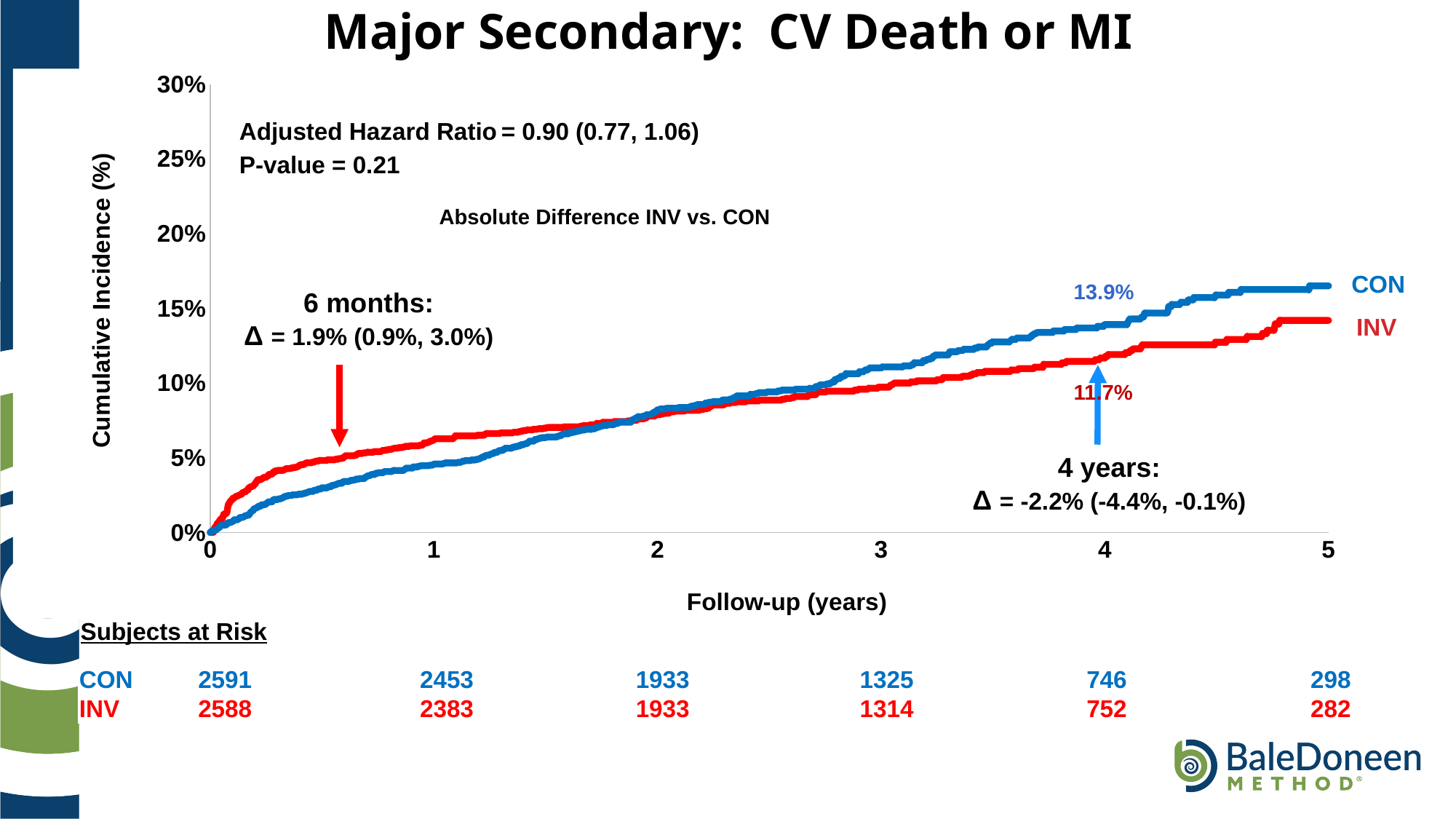
At 6 months, which group has the higher cumulative incidence, CON or INV? INV What kind of chart is shown on the slide? line chart How many INV subjects are at risk at year 5? 282 Do the cumulative incidence curves rise or fall as follow-up time increases? rise What is the cumulative incidence for INV at 4 years? 11.7% How many CON subjects are at risk at year 0? 2591 What adjusted hazard ratio is reported on the chart? 0.90 (0.77, 1.06) By how many percentage points does the CON cumulative incidence exceed INV at 4 years? 2.2% At 4 years, which group has the higher cumulative incidence, CON or INV? CON How many series are plotted on the chart? 2 What is the cumulative incidence for CON at 4 years? 13.9% Is the cumulative incidence for CON at 5 years greater or less than 15%? greater